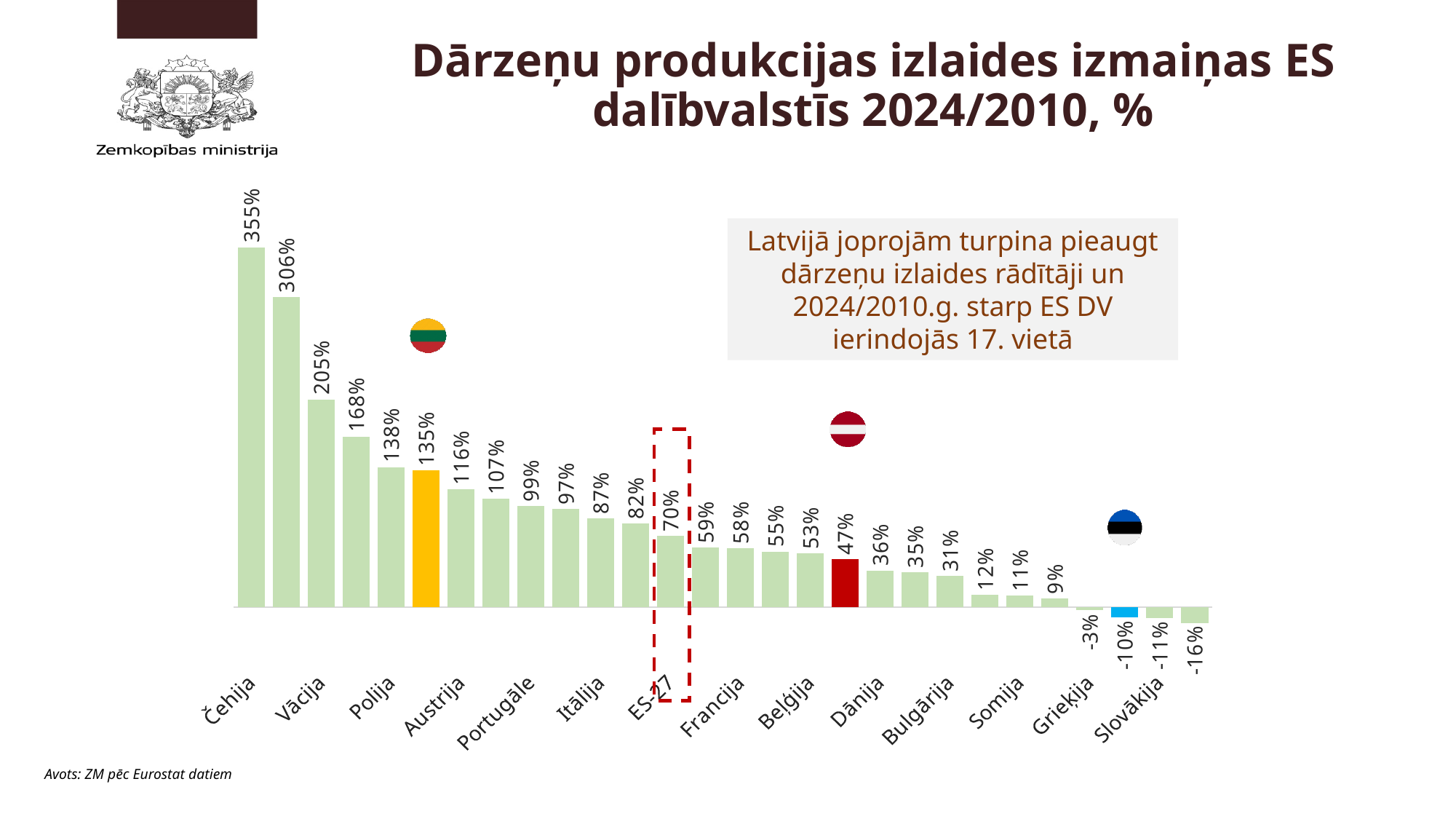
What is the difference between the values for Vācija and Polija? 67 percentage points What is the value shown for Slovākija? -11% What kind of chart is shown on the slide? Bar chart Which country has the highest value in the chart? Čehija What value is labelled on the dark red bar? 47% What is the value shown for ES-27? 70% Which has the larger value, Francija or Beļģija? Francija What is the lowest value shown in the chart? -16% What is the value shown for Polija? 138% How many bars are plotted in the chart? 28 Do the values rise or fall from left to right along the x axis? Fall What is the value shown for Čehija? 355%